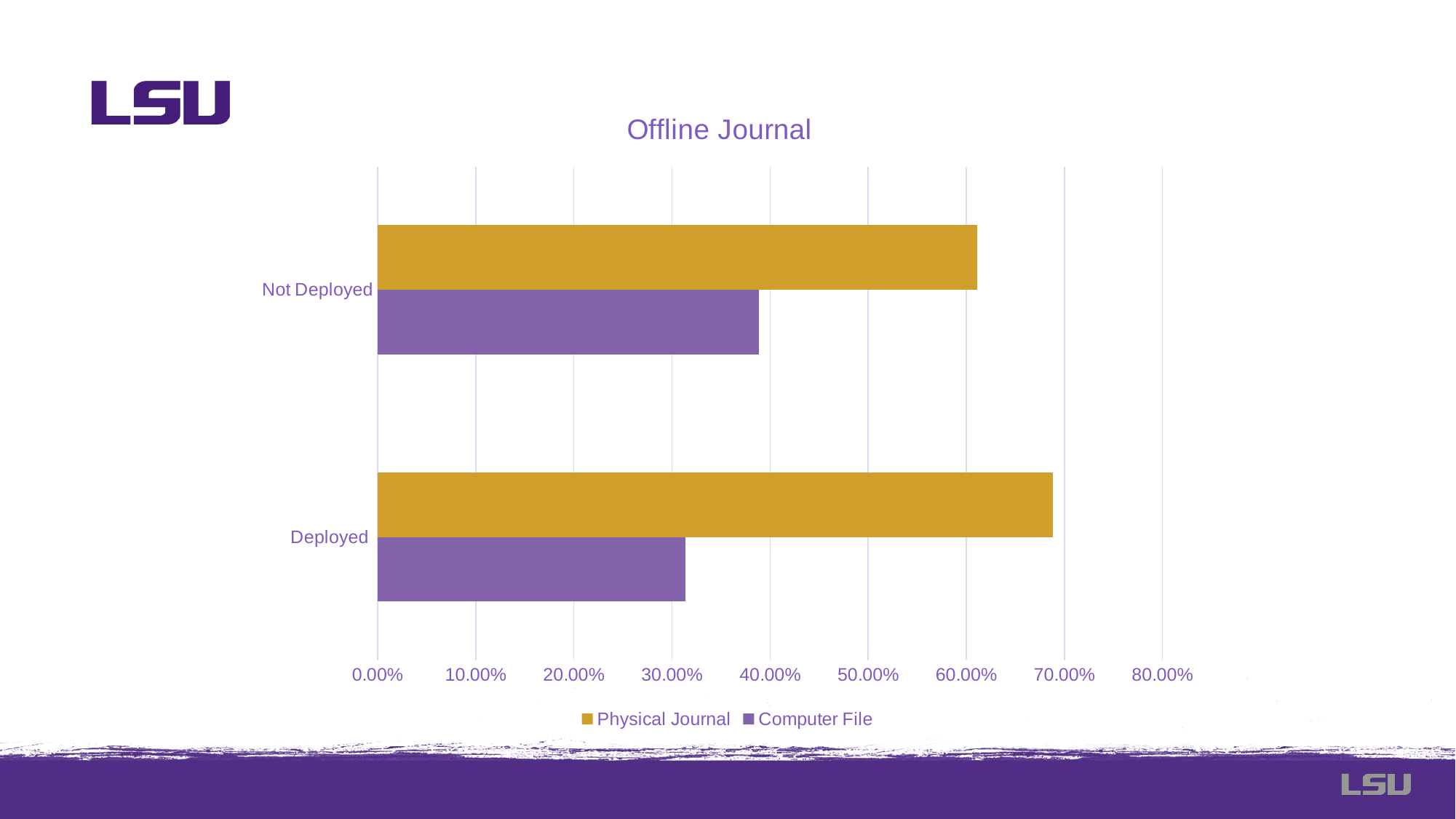
What is the title of the chart? Offline Journal How many series does the legend list? 2 For Deployed, which is larger: Physical Journal or Computer File? Physical Journal Is the Computer File value for Deployed greater or less than 40.00%? less Is the Computer File value for Not Deployed greater or less than 30.00%? greater What type of chart is shown on the slide? bar chart Which series is shown in gold? Physical Journal Which category has the higher Physical Journal value? Deployed Which category has the lower Computer File value? Deployed How many categories are shown on the vertical axis? 2 Is the Physical Journal value for Deployed greater or less than 60.00%? greater